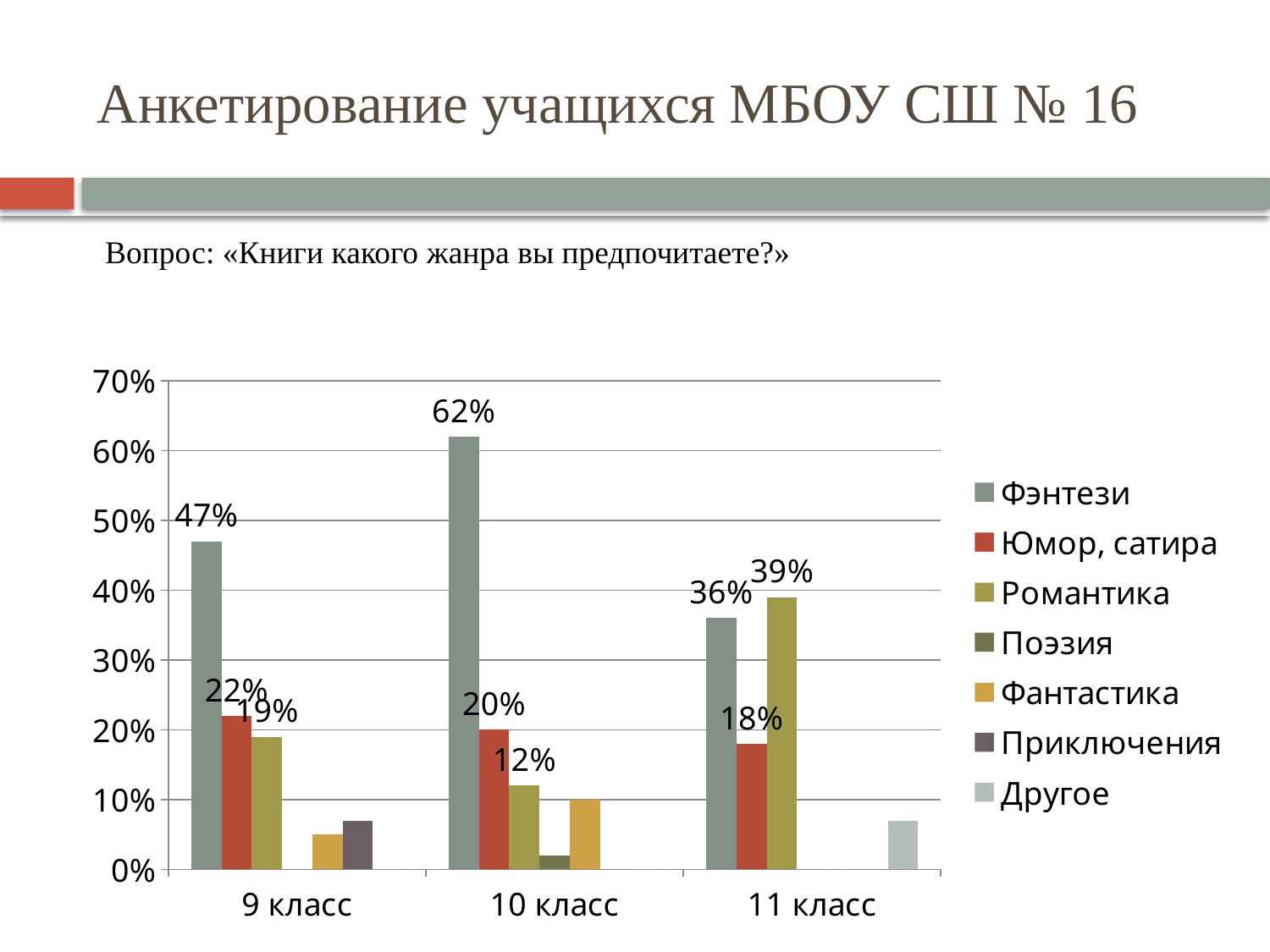
What is the value for Юмор, сатира in 10 класс? 20% Is the value for Фантастика in 9 класс greater or less than 10%? less What is the value for Романтика in 11 класс? 39% What is the value for Фэнтези in 9 класс? 47% In which class does Фэнтези have its highest value? 10 класс Is the value for Другое in 11 класс greater or less than 10%? less In 11 класс, which is larger: Фэнтези or Романтика? Романтика In which class does Романтика have its lowest value? 10 класс How many series does the legend list? 7 What kind of chart is shown on the slide? bar chart How many classes are shown on the x axis? 3 What is the difference between the Фэнтези values for 10 класс and 11 класс? 26%